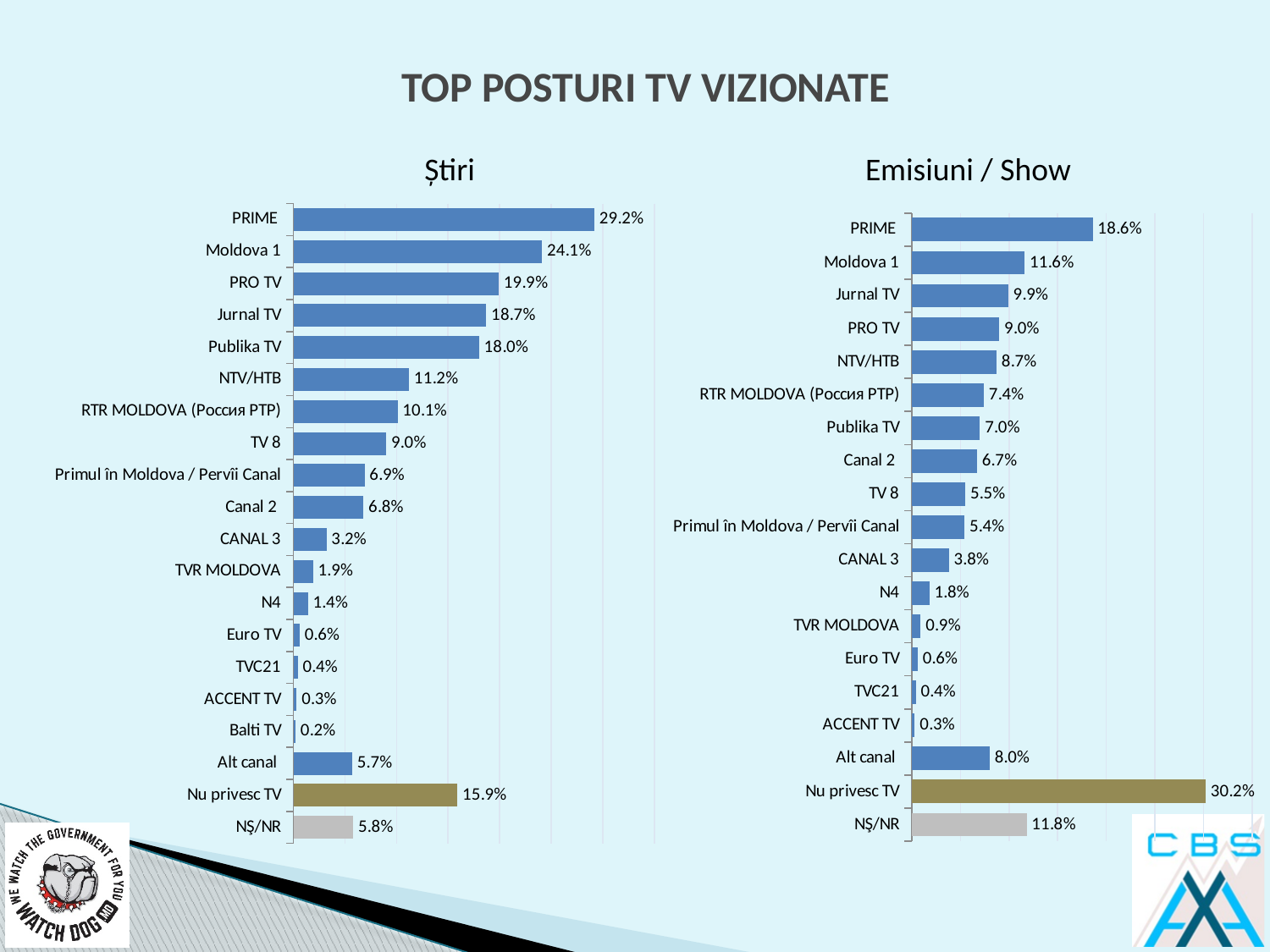
In the Știri chart, which category has the highest value? PRIME What is the title of the slide? TOP POSTURI TV VIZIONATE In the Știri chart, what is the difference between the values for PRIME and Moldova 1? 5.1% How many categories are shown in the Emisiuni / Show chart? 19 In the Emisiuni / Show chart, what is the value for Jurnal TV? 9.9% What kind of chart is the Știri chart? Bar chart In the Știri chart, which is larger: the value for Publika TV or the value for Nu privesc TV? Publika TV In the Știri chart, which category has the lowest value? Balti TV In the Emisiuni / Show chart, which category has the highest value? Nu privesc TV In the Știri chart, what is the value for PRIME? 29.2% In the Emisiuni / Show chart, which is larger: the value for PRO TV or the value for NTV/HTB? PRO TV In the Emisiuni / Show chart, what is the difference between the values for Nu privesc TV and PRIME? 11.6%